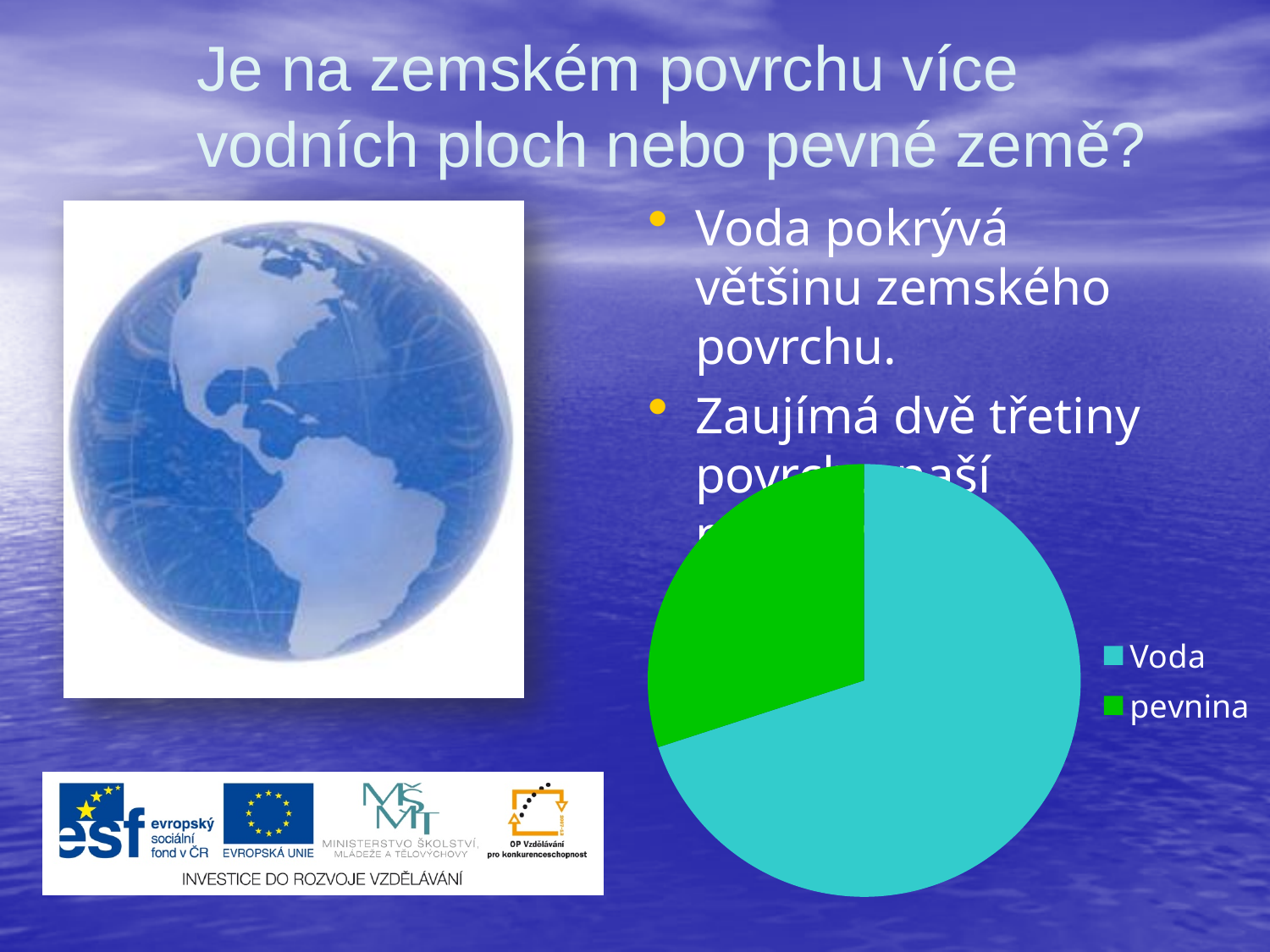
What colour is the Voda slice in the pie chart? cyan How many slices does the pie chart have? 2 Which category has the smallest slice in the pie chart? pevnina Which category has the largest slice in the pie chart? Voda What kind of chart is shown on the slide? pie chart Which slice is larger in the pie chart, Voda or pevnina? Voda What colour is the pevnina slice in the pie chart? green How many entries does the legend of the pie chart list? 2